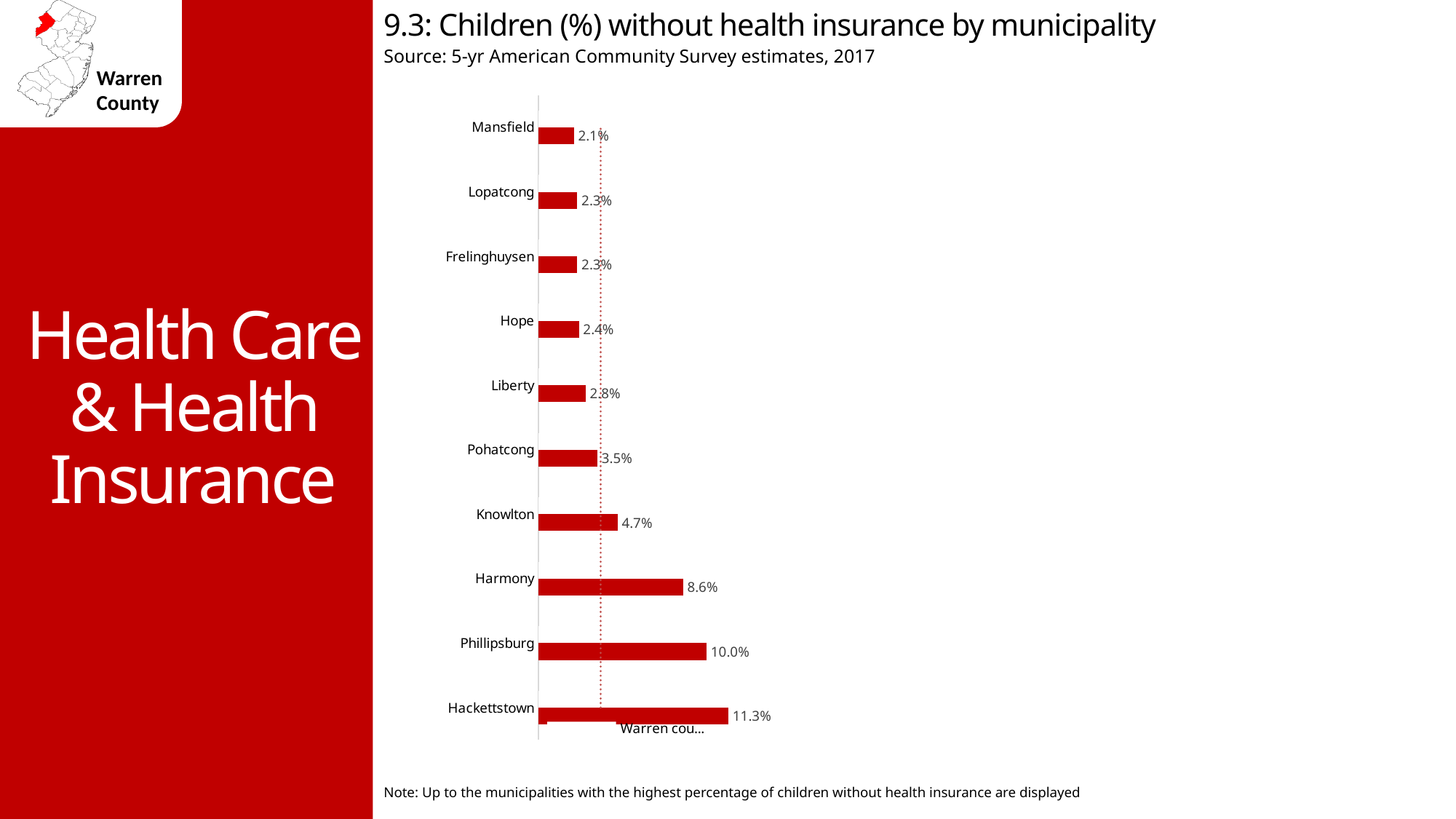
What is the value shown for Phillipsburg? 10.0% What is the difference between the values for Hackettstown and Phillipsburg? 1.3% What is the value for Pohatcong? 3.5% What type of chart is used on this slide? Bar chart What is the difference between the values for Harmony and Knowlton? 3.9% What percentage is shown for Knowlton? 4.7% What is the source of the data shown in the chart? 5-yr American Community Survey estimates, 2017 What percentage of children in Hackettstown are without health insurance? 11.3% Which municipality has the lowest percentage of children without health insurance? Mansfield How many municipalities are shown in the chart? 10 Which municipality has the highest percentage of children without health insurance? Hackettstown Which has a higher percentage of children without health insurance, Liberty or Hope? Liberty